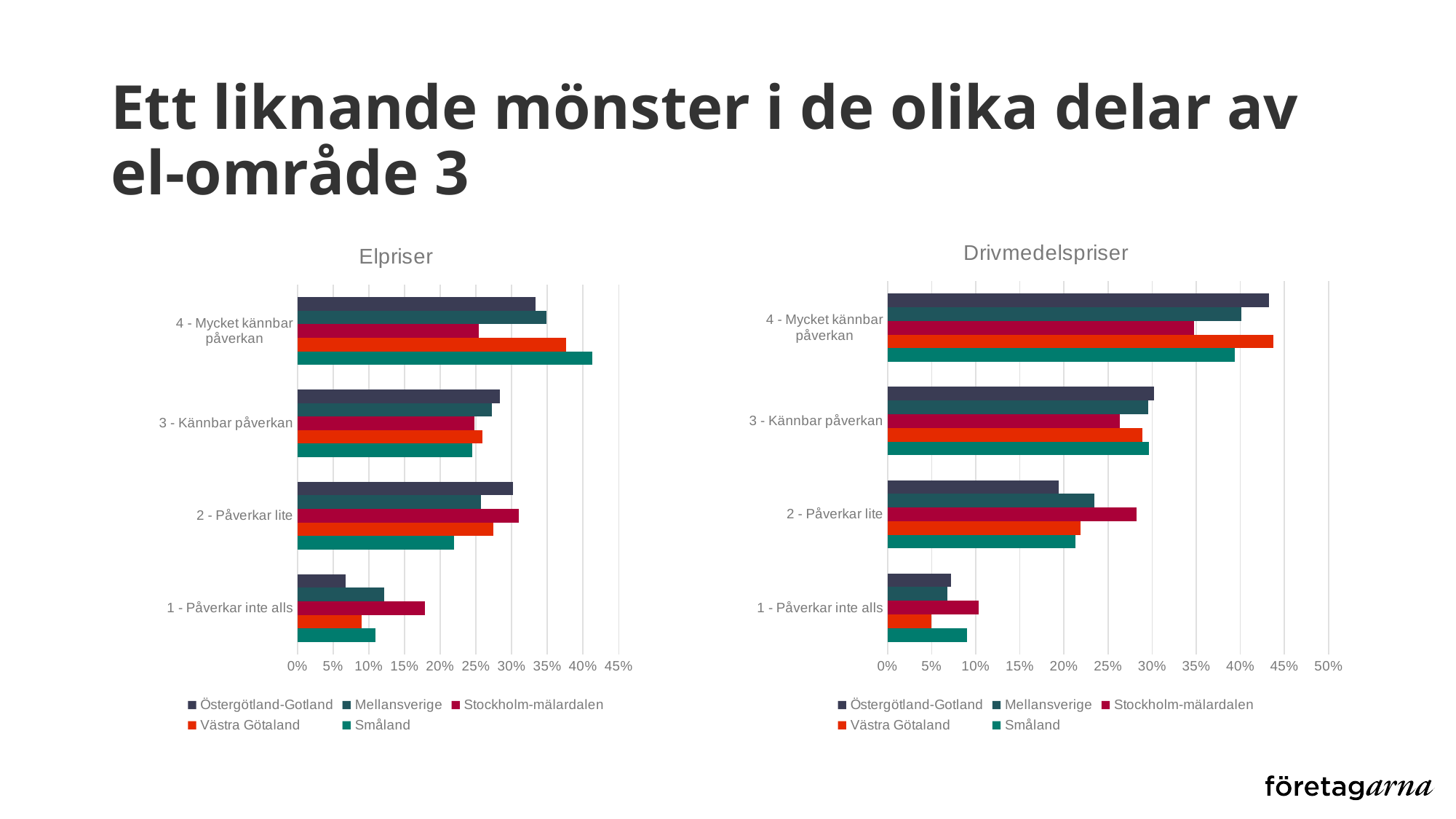
In the Elpriser chart, which series has the highest value in the category '1 - Påverkar inte alls'? Stockholm-mälardalen How many categories are shown on the y axis of the Elpriser chart? 4 In the Drivmedelspriser chart, is the value for Västra Götaland in the category '4 - Mycket kännbar påverkan' greater or less than 40%? greater In the Drivmedelspriser chart, which series has the highest value in the category '2 - Påverkar lite'? Stockholm-mälardalen What is the title of the chart on the right side of the slide? Drivmedelspriser How many series does the legend of the Drivmedelspriser chart list? 5 What kind of chart is the Elpriser chart? bar chart In the Elpriser chart, which series has the highest value in the category '4 - Mycket kännbar påverkan'? Småland In the Elpriser chart, is the value for Östergötland-Gotland in the category '1 - Påverkar inte alls' greater or less than 10%? less In the Elpriser chart, is the value for Småland in the category '4 - Mycket kännbar påverkan' greater or less than 40%? greater In the Drivmedelspriser chart, in the category '4 - Mycket kännbar påverkan', which is larger: Östergötland-Gotland or Stockholm-mälardalen? Östergötland-Gotland In the Drivmedelspriser chart, which series has the lowest value in the category '1 - Påverkar inte alls'? Västra Götaland